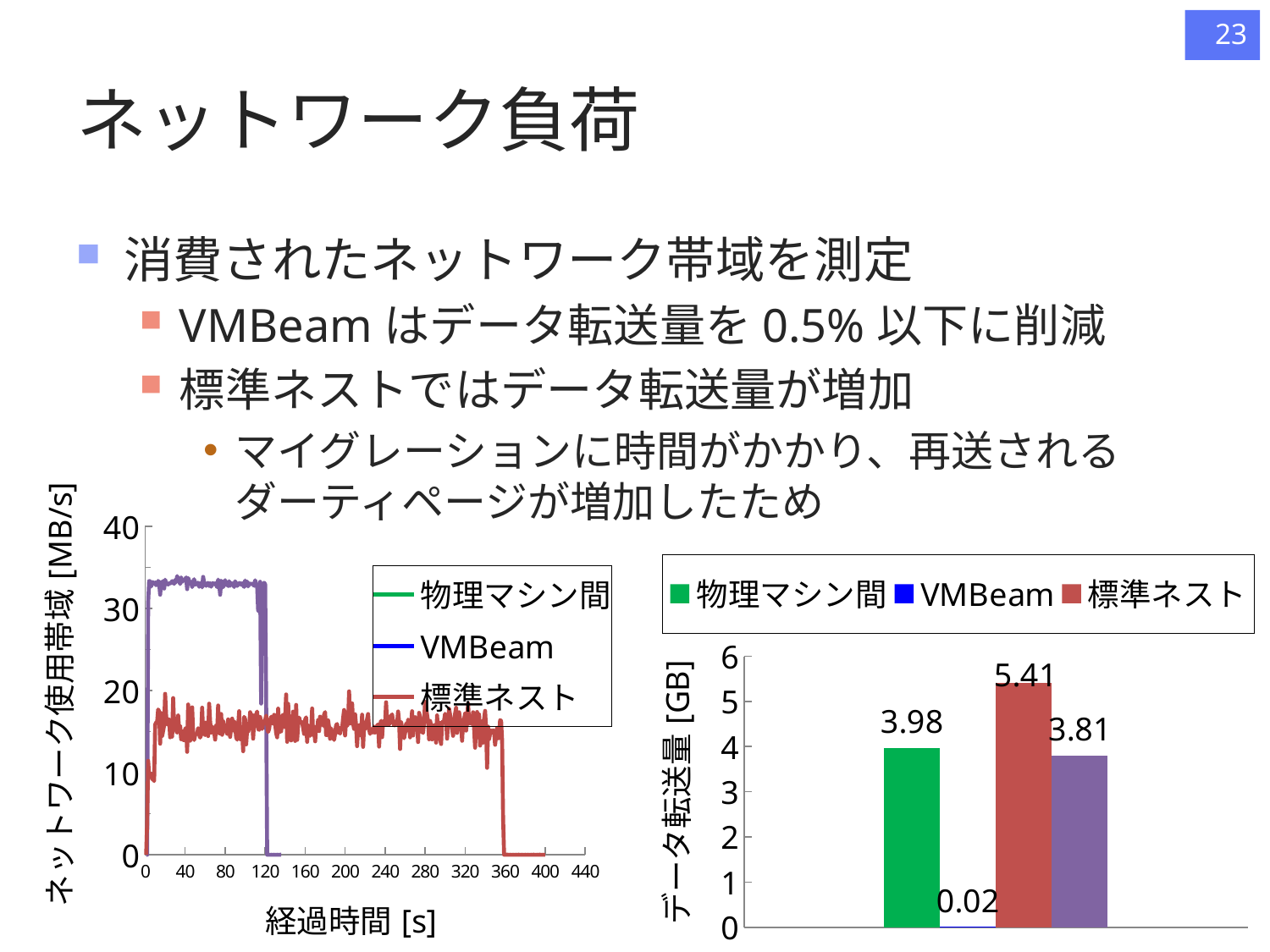
In the line chart on the left, is the 標準ネスト bandwidth at around 200 s greater or less than 20 MB/s? less In the bar chart on the right, what is the data transfer amount for VMBeam? 0.02 In the bar chart on the right, is the value for 標準ネスト greater or less than 5? greater In the bar chart on the right, what is the difference between the data transfer amounts of 標準ネスト and 物理マシン間? 1.43 What kind of chart is the chart on the left of the slide? Line chart How many series does the legend of the bar chart on the right list? 3 In the bar chart on the right, what is the data transfer amount for 標準ネスト? 5.41 In the bar chart on the right, which legend series has the lowest data transfer amount? VMBeam In the bar chart on the right, what is the data transfer amount for 物理マシン間? 3.98 In the bar chart on the right, which legend series has the highest data transfer amount? 標準ネスト In the bar chart on the right, which is larger: the data transfer amount for 物理マシン間 or for VMBeam? 物理マシン間 What is the x-axis label of the line chart on the left? 経過時間 [s]